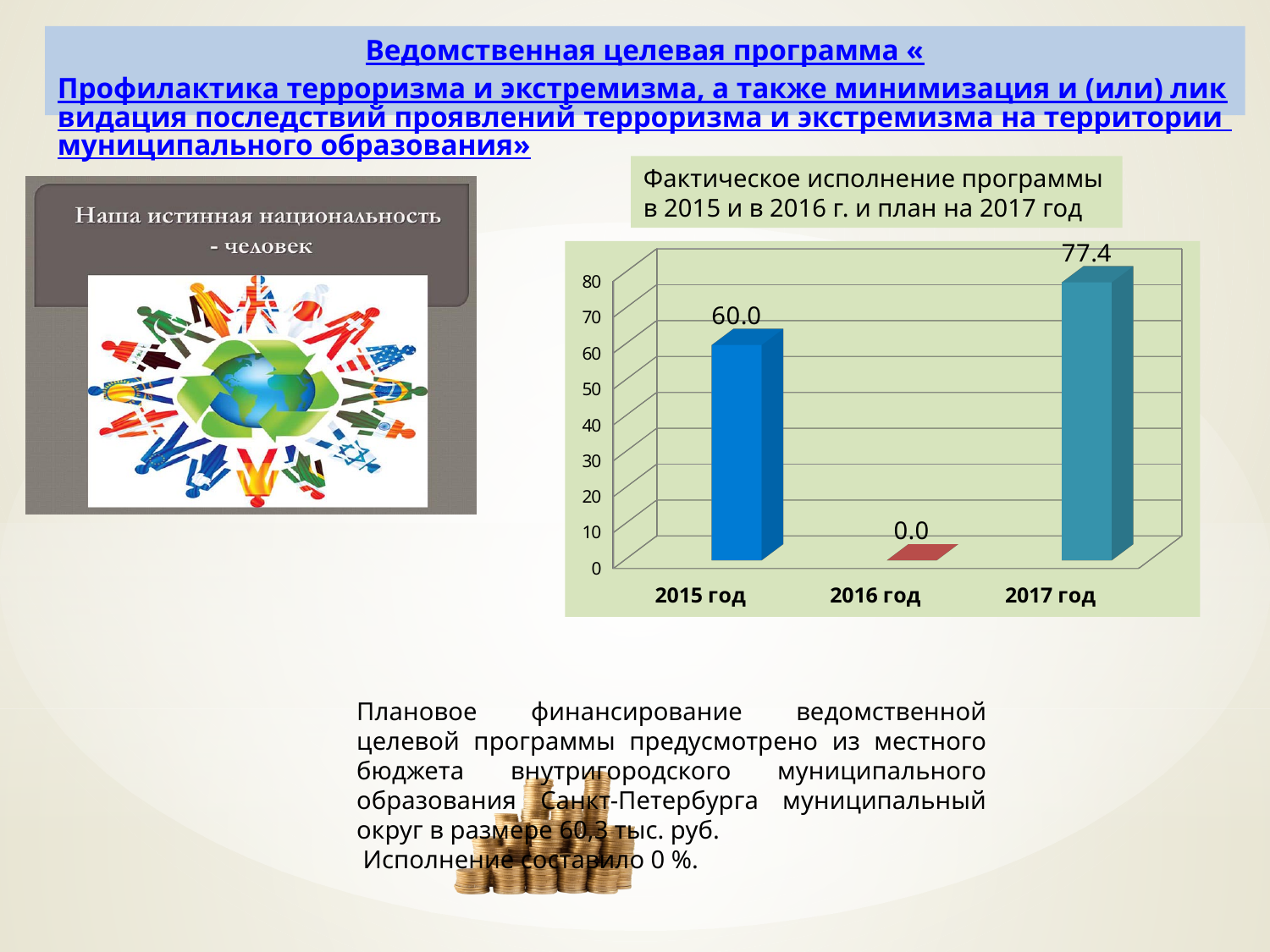
What kind of chart is shown on the slide? bar chart What is the value shown for 2016 год? 0.0 What is the text shown above the chart describing its content? Фактическое исполнение программы в 2015 и в 2016 г. и план на 2017 год How many years (categories) are shown on the x axis of the chart? 3 What is the value shown for 2015 год? 60.0 Is the value for 2015 год greater or less than 50? greater What is the difference between the values for 2017 год and 2015 год? 17.4 Which is larger, the value for 2015 год or the value for 2017 год? 2017 год Which year has the lowest value in the chart? 2016 год What is the highest tick value shown on the vertical axis of the chart? 80 What is the value shown for 2017 год? 77.4 Which year has the highest value in the chart? 2017 год